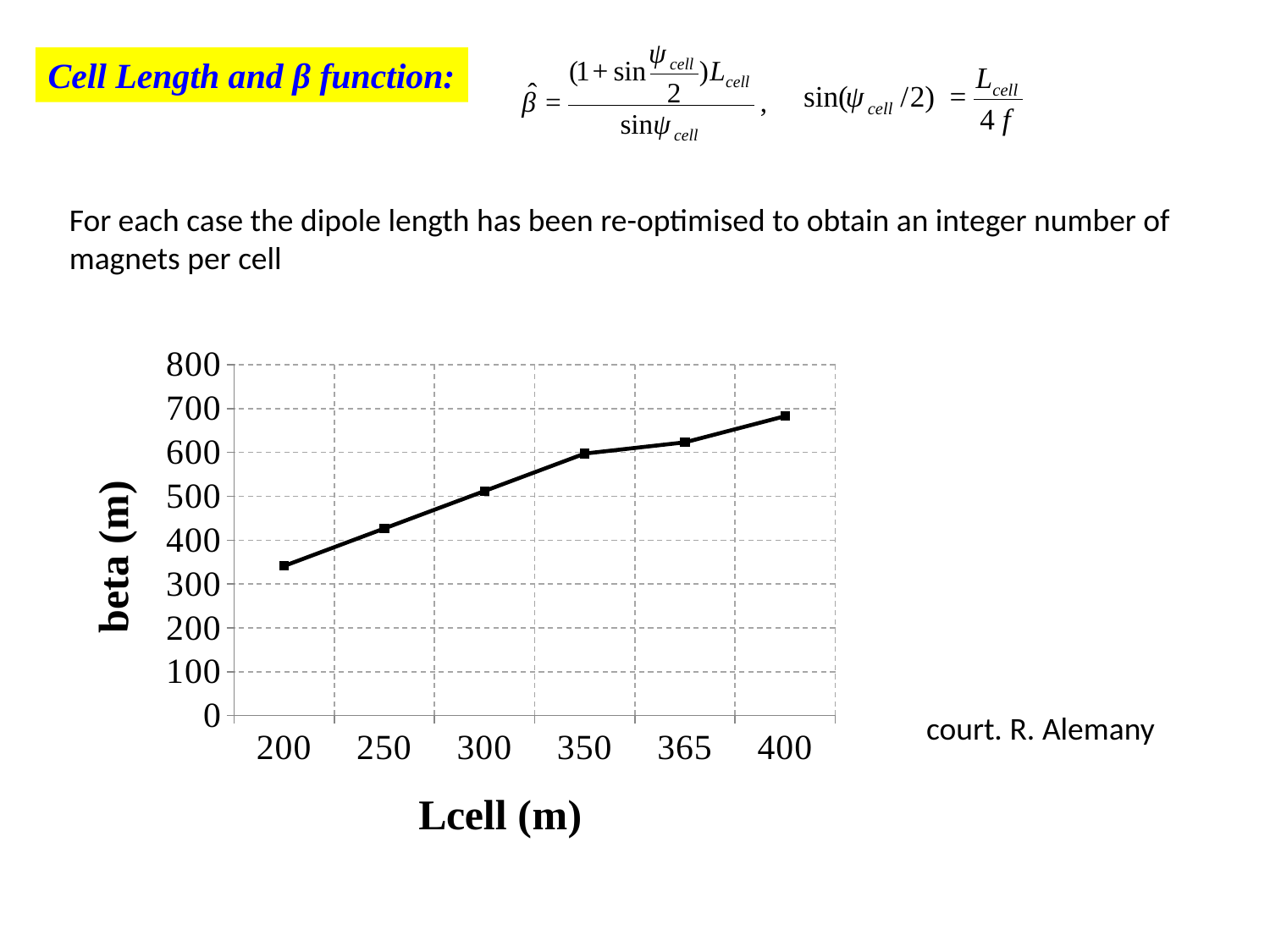
At which Lcell value is beta lowest? 200 At which Lcell value is beta highest? 400 How many data points are plotted on the chart? 6 Do the beta values rise or fall as Lcell increases along the x axis? rise Is the beta value for Lcell = 300 greater or less than 400? greater Is the beta value for Lcell = 350 greater or less than 700? less What is the label of the y axis? beta (m) Which has a larger beta value: Lcell = 250 or Lcell = 365? 365 Is the beta value for Lcell = 200 greater or less than 400? less What kind of chart is shown on the slide? line chart What is the label of the x axis? Lcell (m)